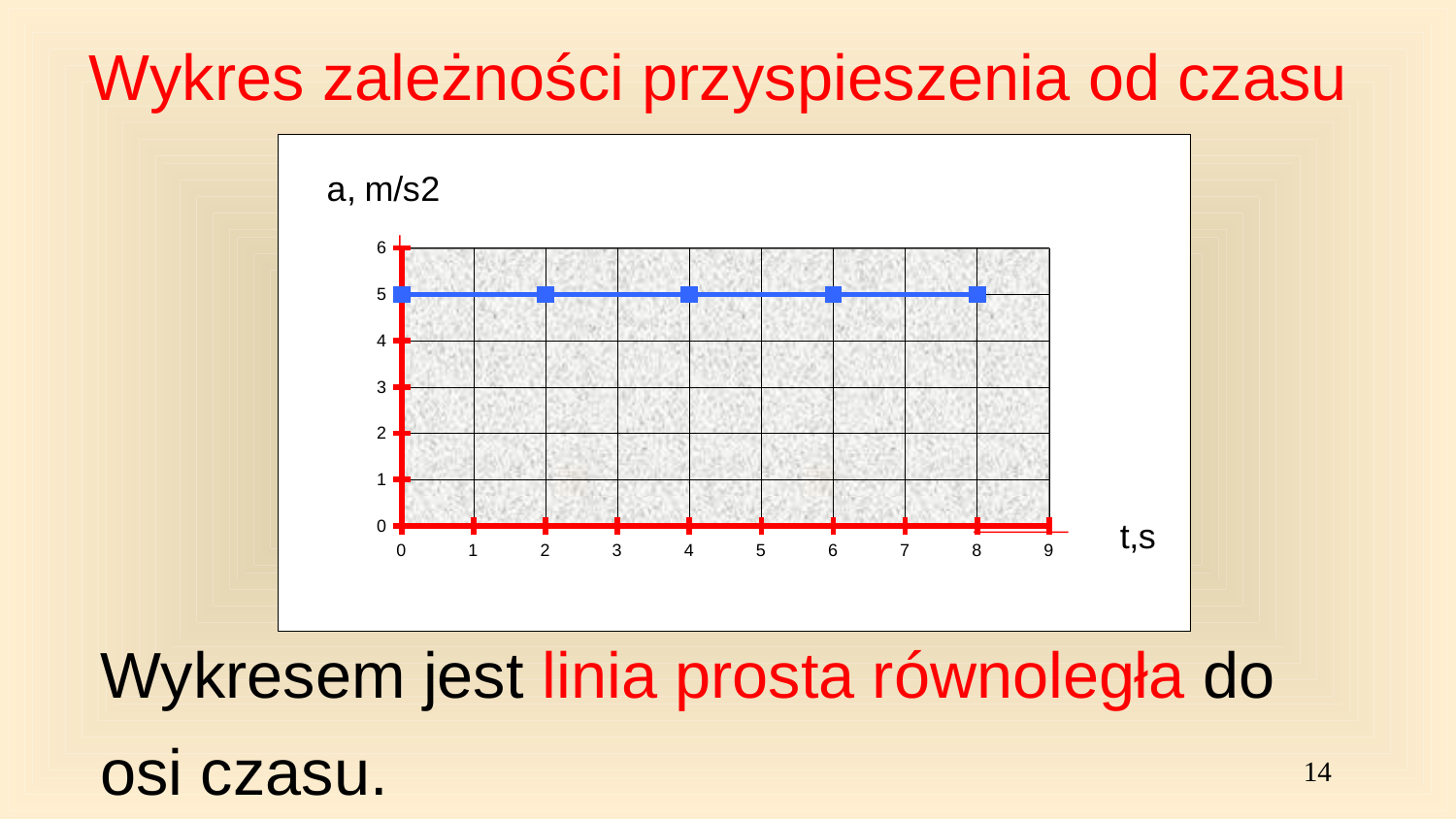
What is the value of a at t = 8? 5 What is the label of the horizontal axis? t,s What is the difference between the value of a at t = 8 and at t = 0? 0 What is the value of a at t = 4? 5 Do the values rise, fall or stay constant as t increases? stay constant Is the value of a at t = 2 greater or less than 6? less How many data points are plotted on the line? 5 What kind of chart is shown on the slide? line chart What is the highest value shown on the vertical axis? 6 What is the value of a at t = 0? 5 What is the label of the vertical axis? a, m/s2 Is the value of a at t = 6 greater or less than 3? greater